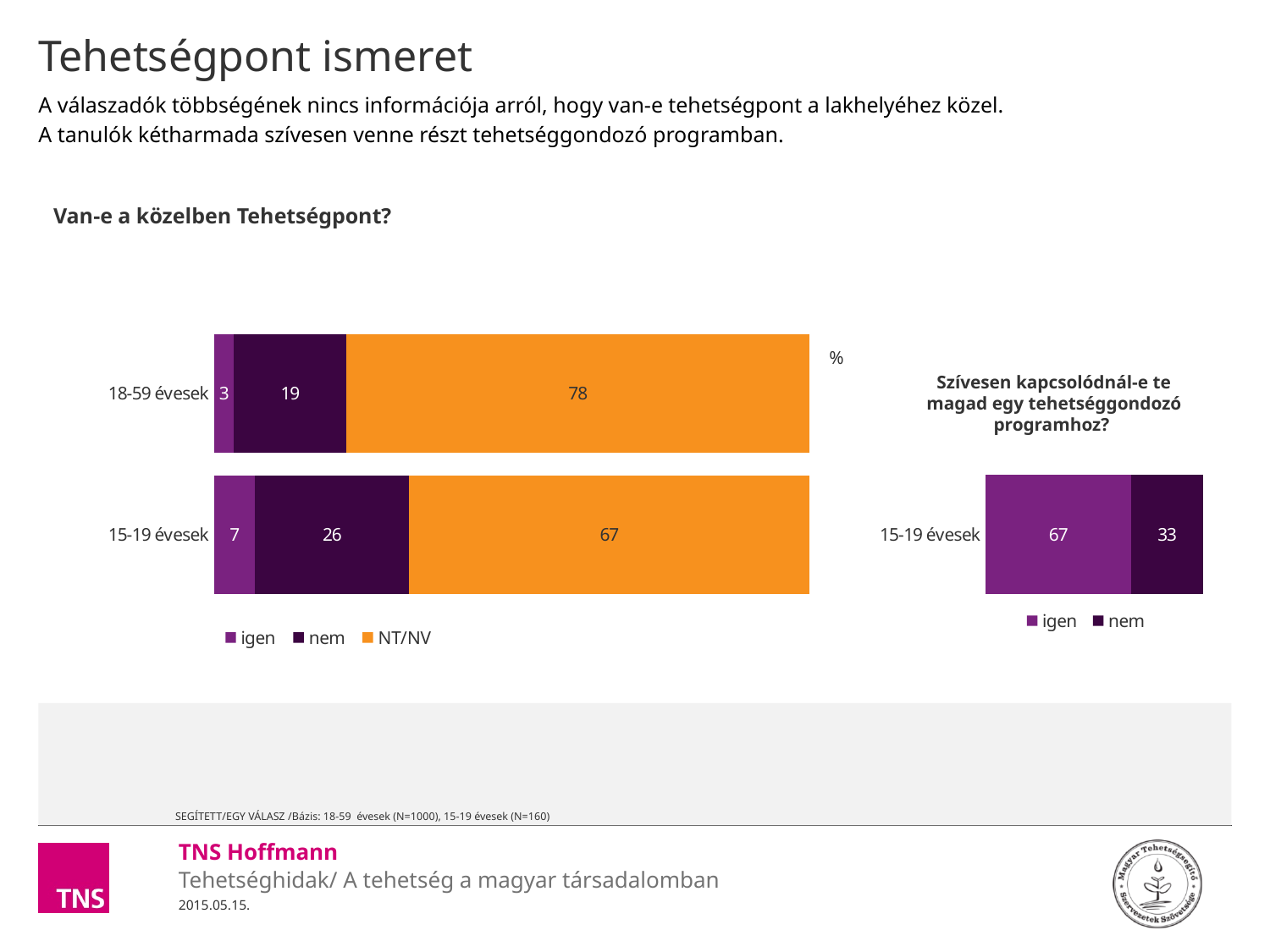
In the 'Szívesen kapcsolódnál-e te magad egy tehetséggondozó programhoz?' chart, what is the 'nem' value for 15-19 évesek? 33 In the 'Van-e a közelben Tehetségpont?' chart, how many categories are shown? 2 In the 'Szívesen kapcsolódnál-e te magad egy tehetséggondozó programhoz?' chart, what is the difference between the 'igen' and 'nem' values? 34 In the 'Szívesen kapcsolódnál-e te magad egy tehetséggondozó programhoz?' chart, what is the 'igen' value for 15-19 évesek? 67 In the 'Van-e a közelben Tehetségpont?' chart, what is the 'nem' value for 15-19 évesek? 26 In the 'Van-e a közelben Tehetségpont?' chart, how many series does the legend list? 3 In the 'Van-e a közelben Tehetségpont?' chart, which category has the higher 'igen' value, 18-59 évesek or 15-19 évesek? 15-19 évesek In the 'Van-e a közelben Tehetségpont?' chart, what is the 'igen' value for 18-59 évesek? 3 In the 'Van-e a közelben Tehetségpont?' chart, what is the difference between the NT/NV values for 18-59 évesek and 15-19 évesek? 11 In the 'Van-e a közelben Tehetségpont?' chart, what is the total of the stacked bar for 15-19 évesek? 100 In the 'Van-e a közelben Tehetségpont?' chart, what is the NT/NV value for 18-59 évesek? 78 What kind of chart is the 'Van-e a közelben Tehetségpont?' chart? Stacked bar chart